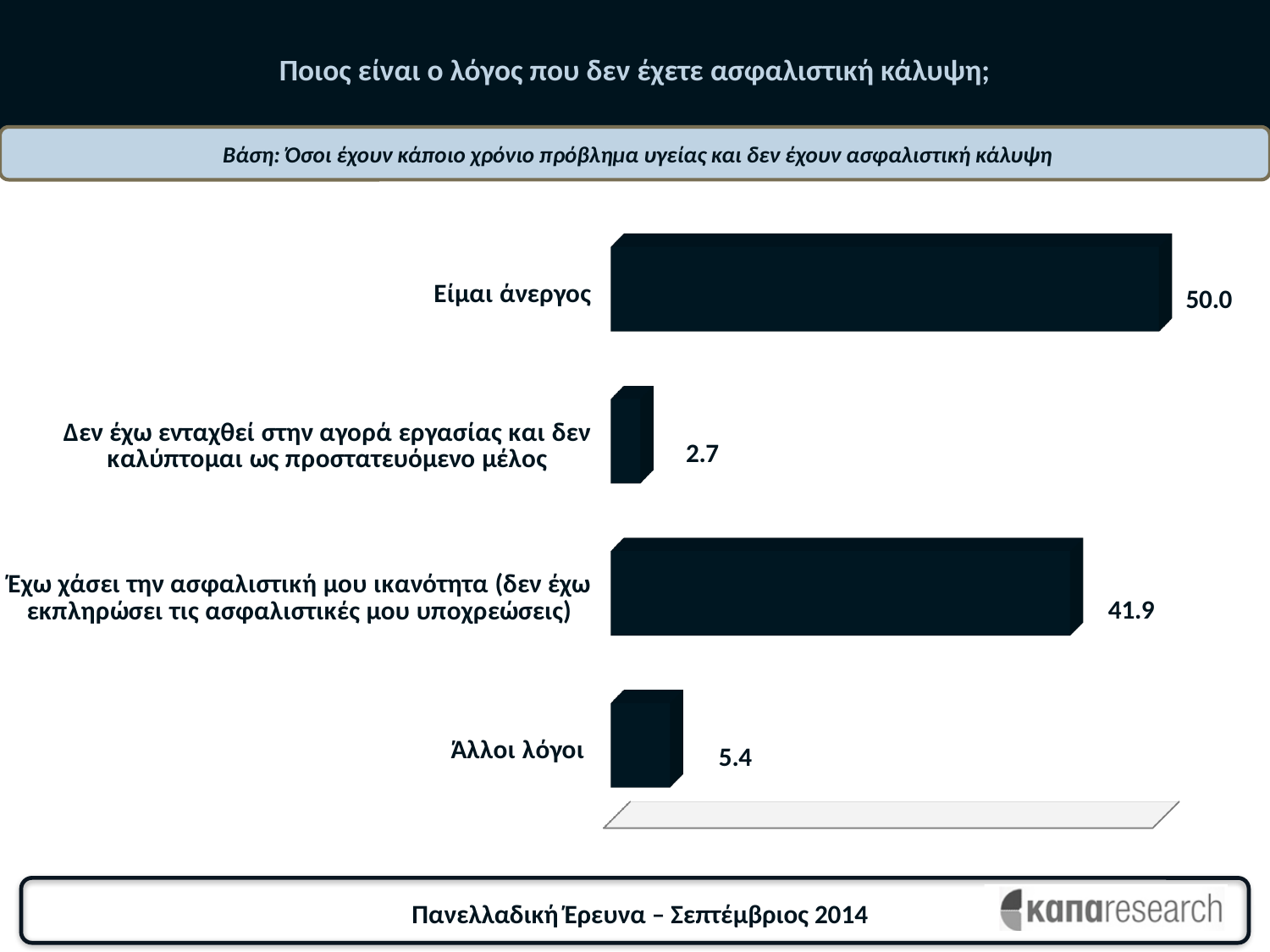
What is the difference between the values for 'Είμαι άνεργος' and 'Έχω χάσει την ασφαλιστική μου ικανότητα'? 8.1 Which is larger: the value for 'Άλλοι λόγοι' or the value for 'Δεν έχω ενταχθεί στην αγορά εργασίας και δεν καλύπτομαι ως προστατευόμενο μέλος'? Άλλοι λόγοι How many categories are shown in the chart? 4 What is the value for 'Άλλοι λόγοι'? 5.4 What is the title of the slide? Ποιος είναι ο λόγος που δεν έχετε ασφαλιστική κάλυψη; Which category has the lowest value? Δεν έχω ενταχθεί στην αγορά εργασίας και δεν καλύπτομαι ως προστατευόμενο μέλος What is the difference between the values for 'Άλλοι λόγοι' and 'Δεν έχω ενταχθεί στην αγορά εργασίας'? 2.7 Which category has the highest value? Είμαι άνεργος What is the value for 'Έχω χάσει την ασφαλιστική μου ικανότητα (δεν έχω εκπληρώσει τις ασφαλιστικές μου υποχρεώσεις)'? 41.9 What is the value for 'Δεν έχω ενταχθεί στην αγορά εργασίας και δεν καλύπτομαι ως προστατευόμενο μέλος'? 2.7 What kind of chart is shown on the slide? Bar chart What is the value for 'Είμαι άνεργος'? 50.0